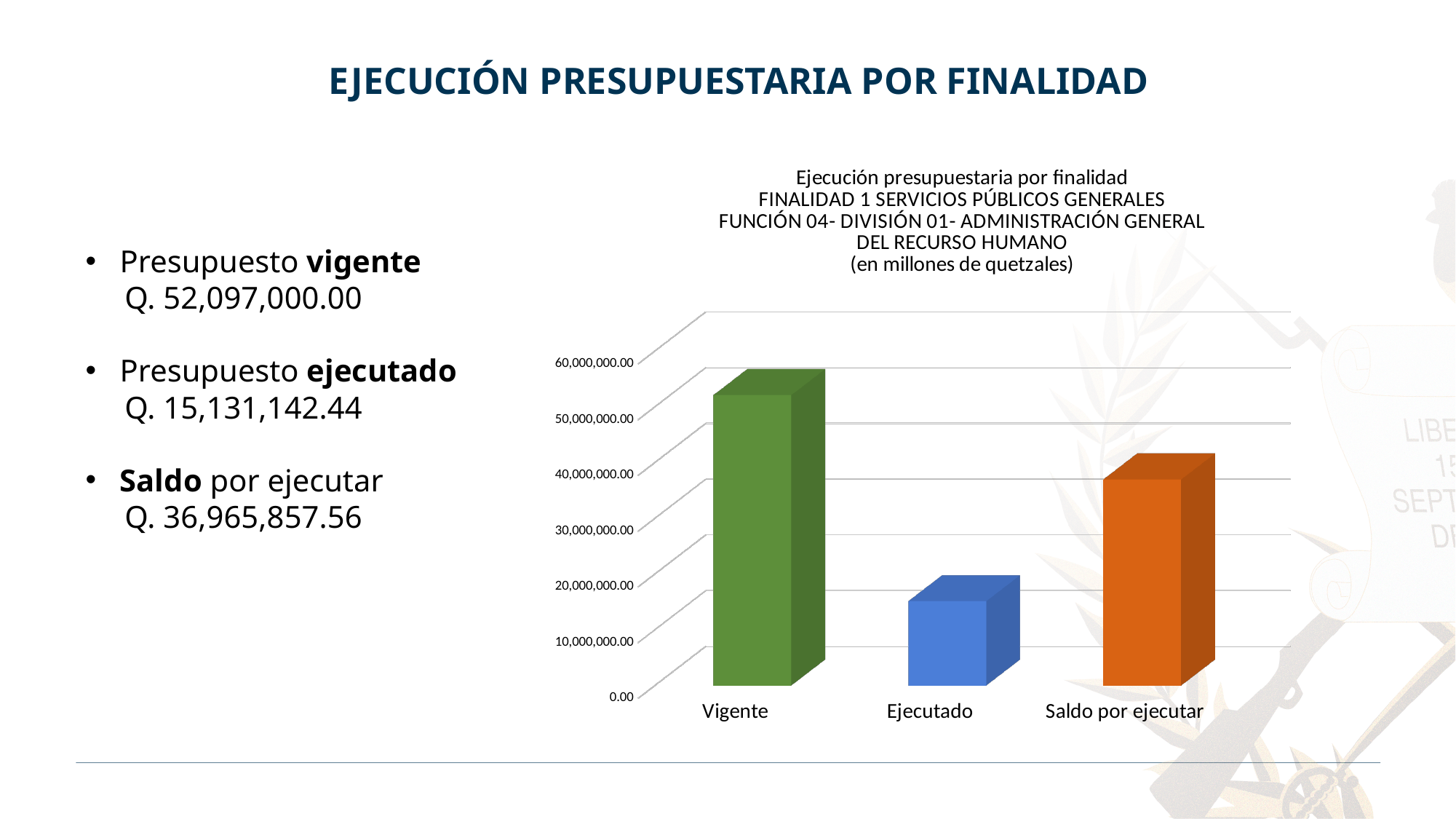
What kind of chart is shown on the slide? bar chart Is the value for Saldo por ejecutar greater or less than 40,000,000.00? less Which category has the highest bar on the chart? Vigente Is the value for Vigente greater or less than 50,000,000.00? greater Is the value for Ejecutado greater or less than 20,000,000.00? less What unit does the chart title say the values are in? millones de quetzales Which category has the lowest bar on the chart? Ejecutado How many categories are plotted on the chart? 3 According to the text on the slide, what is the Presupuesto ejecutado? Q. 15,131,142.44 What colour is the Ejecutado bar? blue Which bar is taller, Ejecutado or Saldo por ejecutar? Saldo por ejecutar